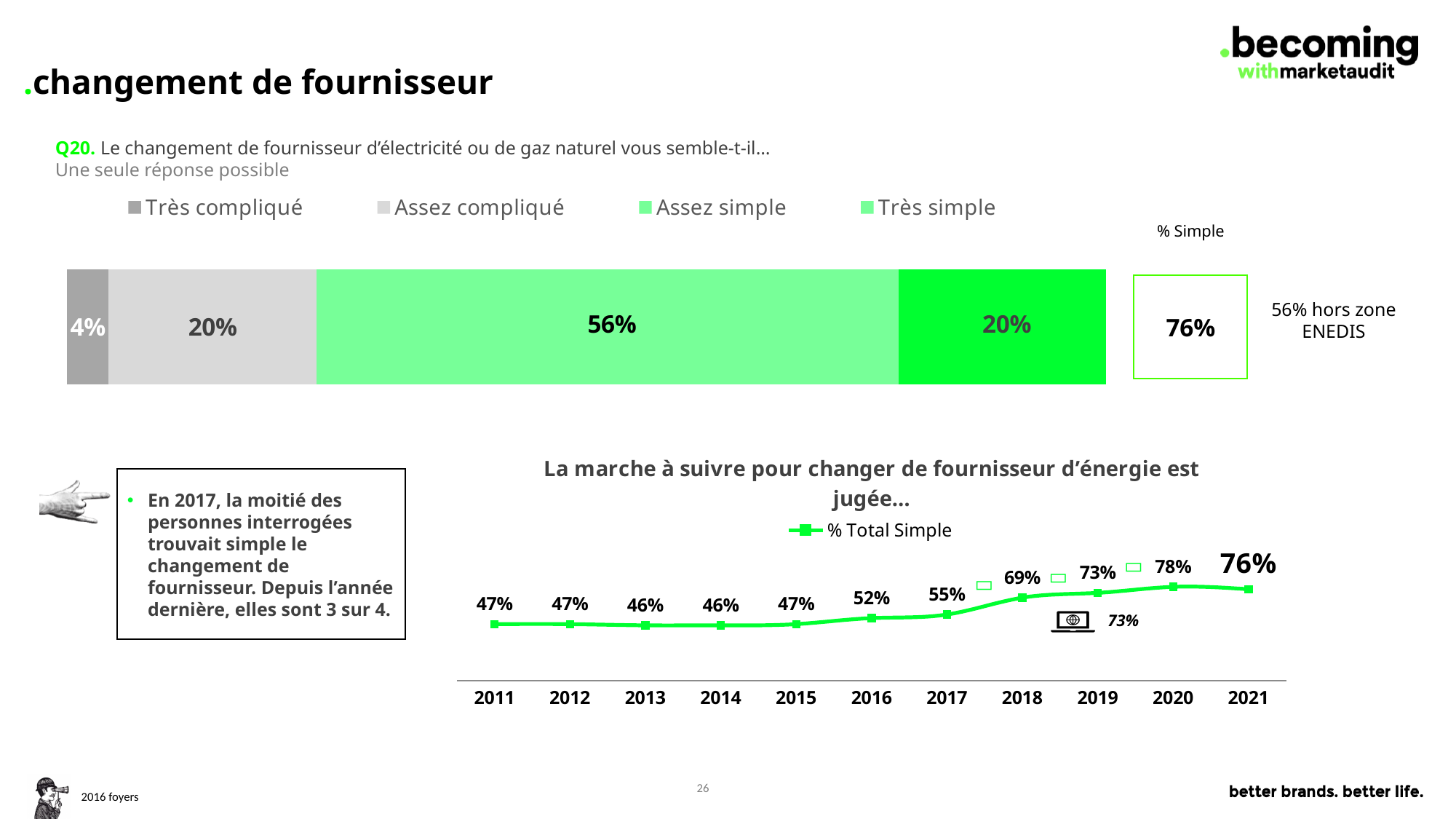
In the top stacked bar chart, which response category has the largest share? Assez simple In the chart titled 'La marche à suivre pour changer de fournisseur d'énergie est jugée…', which year has the highest value? 2020 In the chart titled 'La marche à suivre pour changer de fournisseur d'énergie est jugée…', what is the value for 2018? 69% In the top stacked bar chart, what percentage of respondents answered 'Très compliqué'? 4% In the chart titled 'La marche à suivre pour changer de fournisseur d'énergie est jugée…', what is the value for 2021? 76% In the top stacked bar chart, what percentage of respondents answered 'Assez simple'? 56% In the chart titled 'La marche à suivre pour changer de fournisseur d'énergie est jugée…', how many years are plotted on the x axis? 11 In the top stacked bar chart, what is the combined share of 'Assez simple' and 'Très simple'? 76% What kind of chart is the one titled 'La marche à suivre pour changer de fournisseur d'énergie est jugée…'? Line chart In the chart titled 'La marche à suivre pour changer de fournisseur d'énergie est jugée…', what is the difference between the 2020 value and the 2017 value? 23% In the chart titled 'La marche à suivre pour changer de fournisseur d'énergie est jugée…', what is the name of the plotted series in the legend? % Total Simple How many series does the legend of the top stacked bar chart list? 4